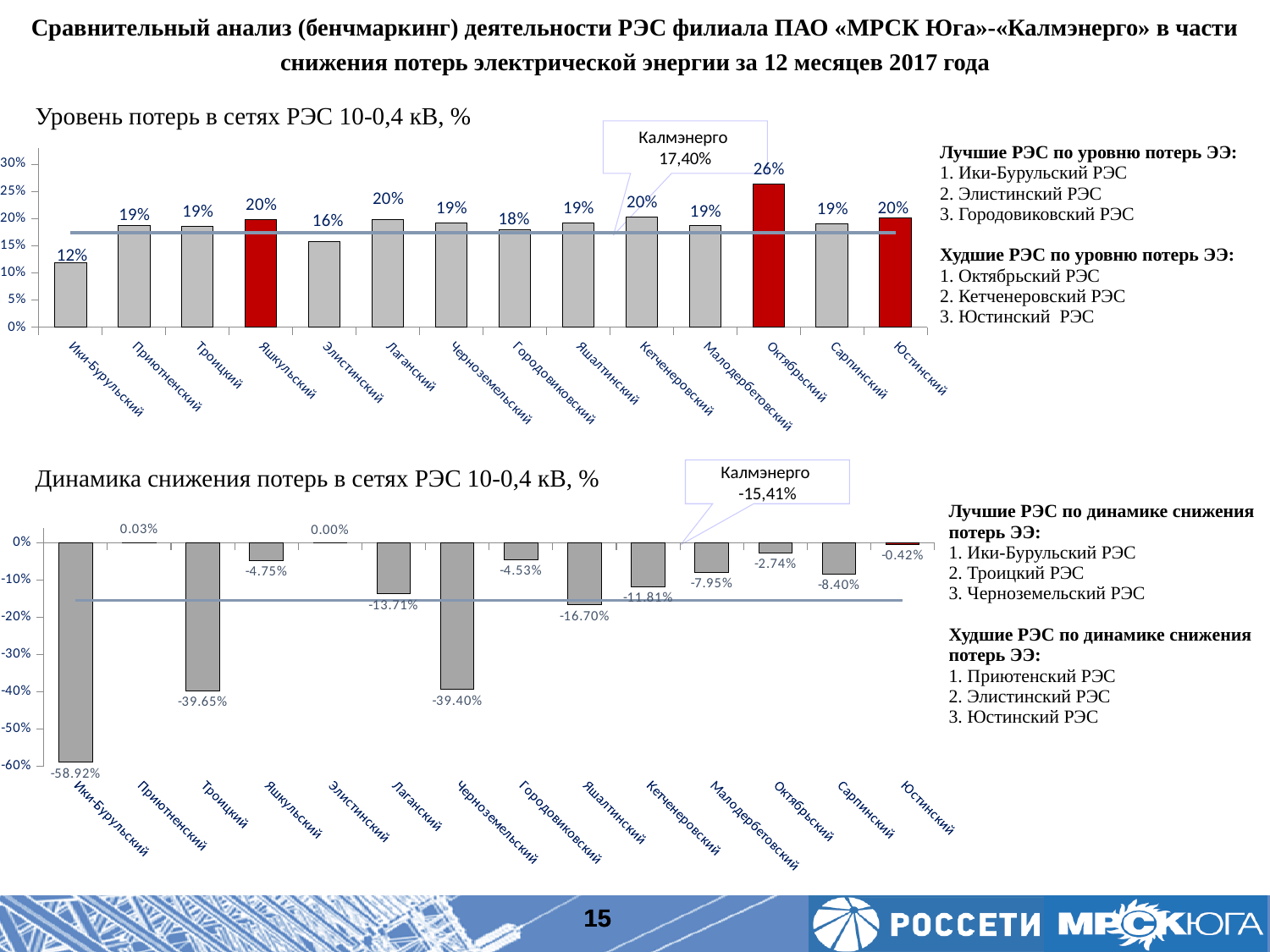
What type of chart is the bottom chart 'Динамика снижения потерь в сетях РЭС 10-0,4 кВ, %'? Bar chart In the top chart 'Уровень потерь в сетях РЭС 10-0,4 кВ, %', which category has the lowest value? Ики-Бурульский In the top chart 'Уровень потерь в сетях РЭС 10-0,4 кВ, %', what value is shown in the callout for Калмэнерго? 17,40% In the top chart 'Уровень потерь в сетях РЭС 10-0,4 кВ, %', how many categories are shown on the x axis? 14 In the top chart 'Уровень потерь в сетях РЭС 10-0,4 кВ, %', which category has the highest value? Октябрьский In the bottom chart 'Динамика снижения потерь в сетях РЭС 10-0,4 кВ, %', what is the value for Черноземельский? -39.40% In the top chart 'Уровень потерь в сетях РЭС 10-0,4 кВ, %', what is the value for Ики-Бурульский? 12% In the bottom chart 'Динамика снижения потерь в сетях РЭС 10-0,4 кВ, %', what is the value for Ики-Бурульский? -58.92% In the bottom chart 'Динамика снижения потерь в сетях РЭС 10-0,4 кВ, %', which is larger, the value for Лаганский or the value for Яшалтинский? Лаганский In the bottom chart 'Динамика снижения потерь в сетях РЭС 10-0,4 кВ, %', which category has the highest value? Приютненский In the top chart 'Уровень потерь в сетях РЭС 10-0,4 кВ, %', what is the difference between Октябрьский and Элистинский? 10% In the bottom chart 'Динамика снижения потерь в сетях РЭС 10-0,4 кВ, %', what value is shown in the callout for Калмэнерго? -15,41%